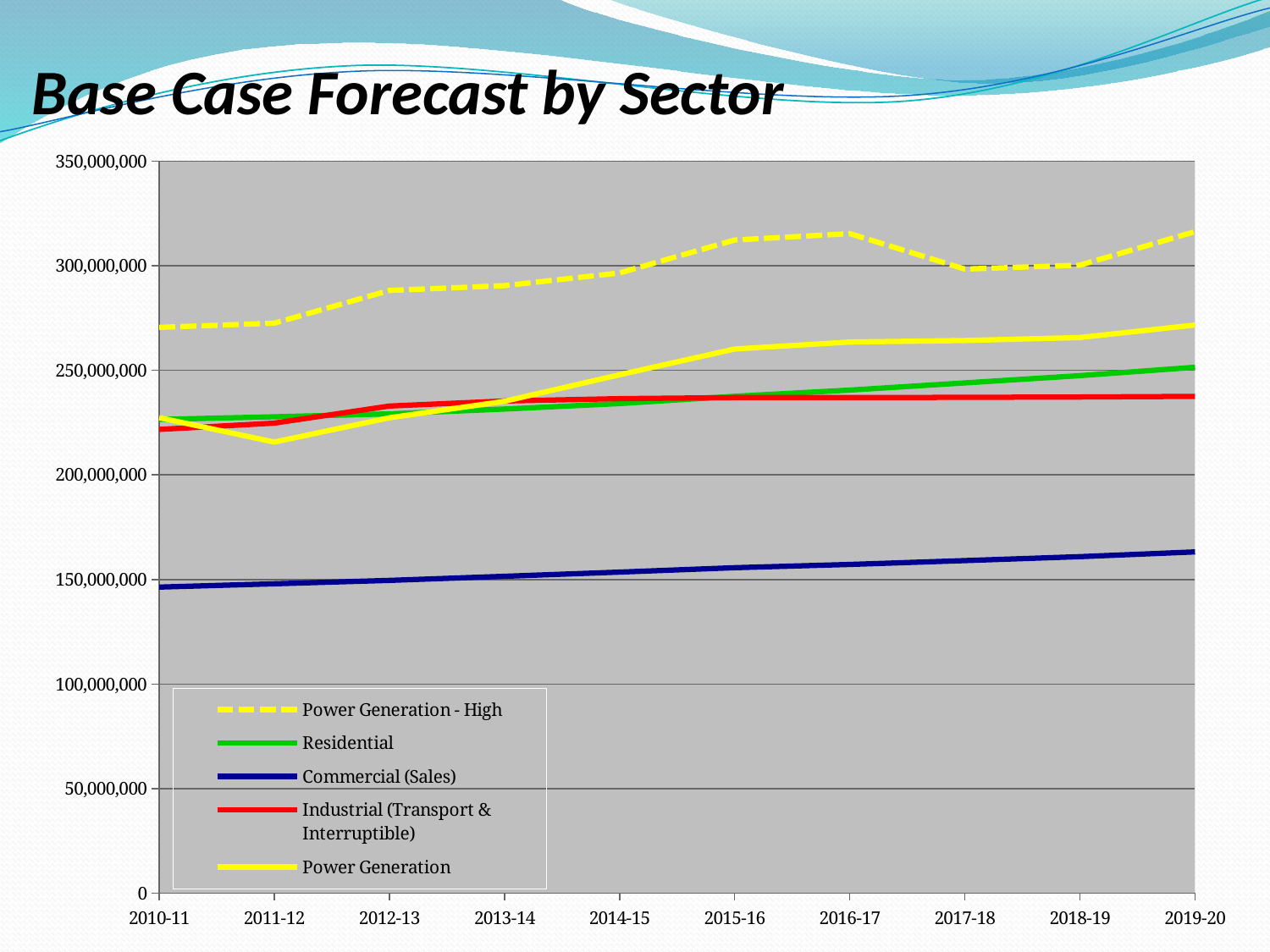
Which is larger in 2019-20, Power Generation or Industrial (Transport & Interruptible)? Power Generation Is the value for Commercial (Sales) in 2010-11 greater or less than 150,000,000? less How many series does the legend list? 5 Which series has the lowest values across the whole forecast period? Commercial (Sales) How many fiscal years are shown along the x axis? 10 Does the Commercial (Sales) series rise or fall from 2010-11 to 2019-20? rise What is the title of the chart? Base Case Forecast by Sector Is the value for Power Generation - High in 2016-17 greater or less than 300,000,000? greater Which series is drawn with a dashed line? Power Generation - High What kind of chart is shown on the slide? line chart Which series has the highest values across the whole forecast period? Power Generation - High